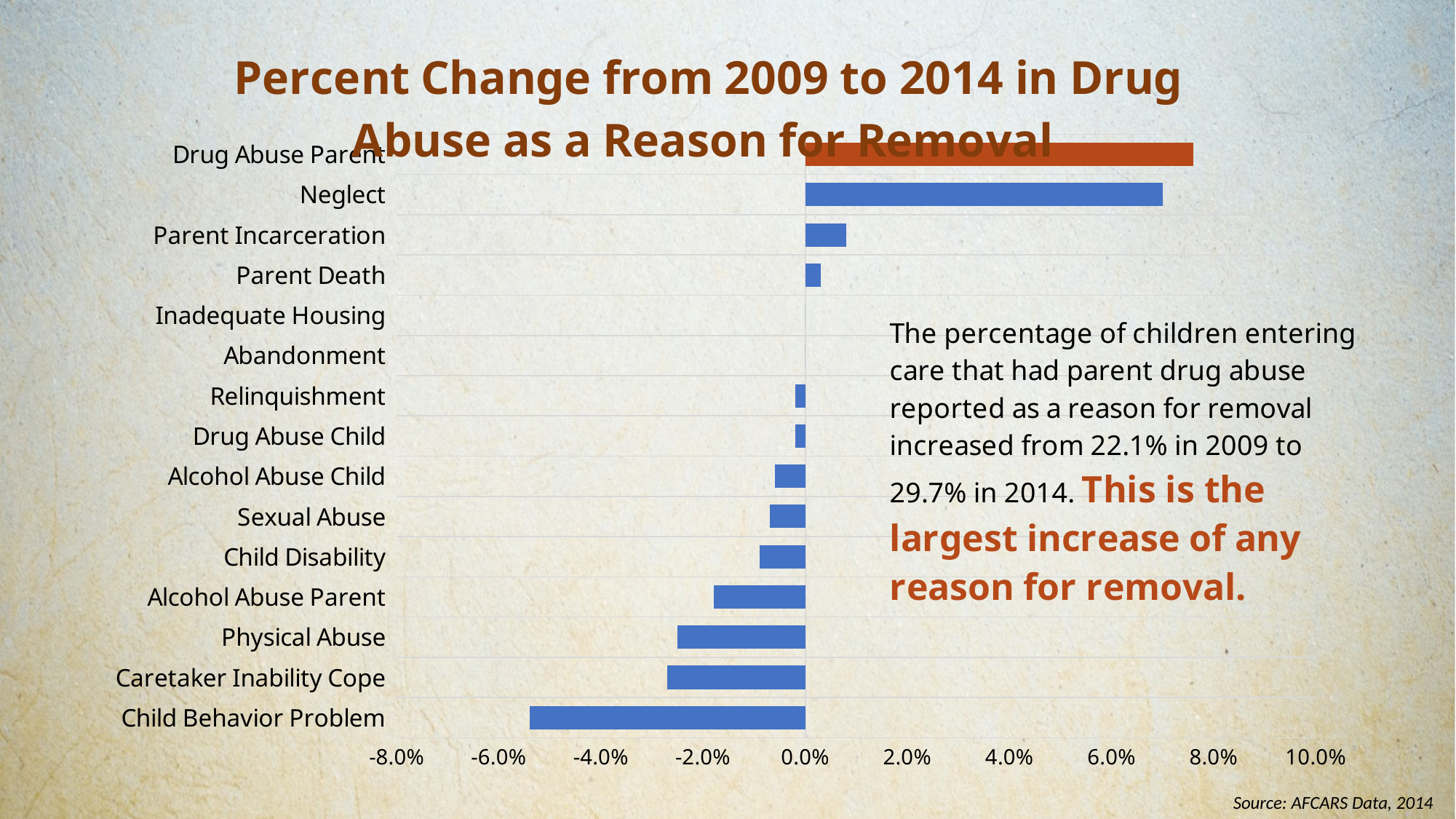
Is the value for Physical Abuse greater or less than -2.0%? less Which category has the lowest percent change? Child Behavior Problem Is the value for Caretaker Inability Cope greater or less than -2.0%? less Is the value for Neglect greater or less than 6.0%? greater Which has the lower percent change, Physical Abuse or Child Behavior Problem? Child Behavior Problem Which category has the highest percent change? Drug Abuse Parent How many categories are plotted on the chart? 15 Which category's bar is drawn in a different colour (orange) from the rest? Drug Abuse Parent What kind of chart is shown on the slide? Bar chart Which has the larger percent change, Neglect or Parent Incarceration? Neglect